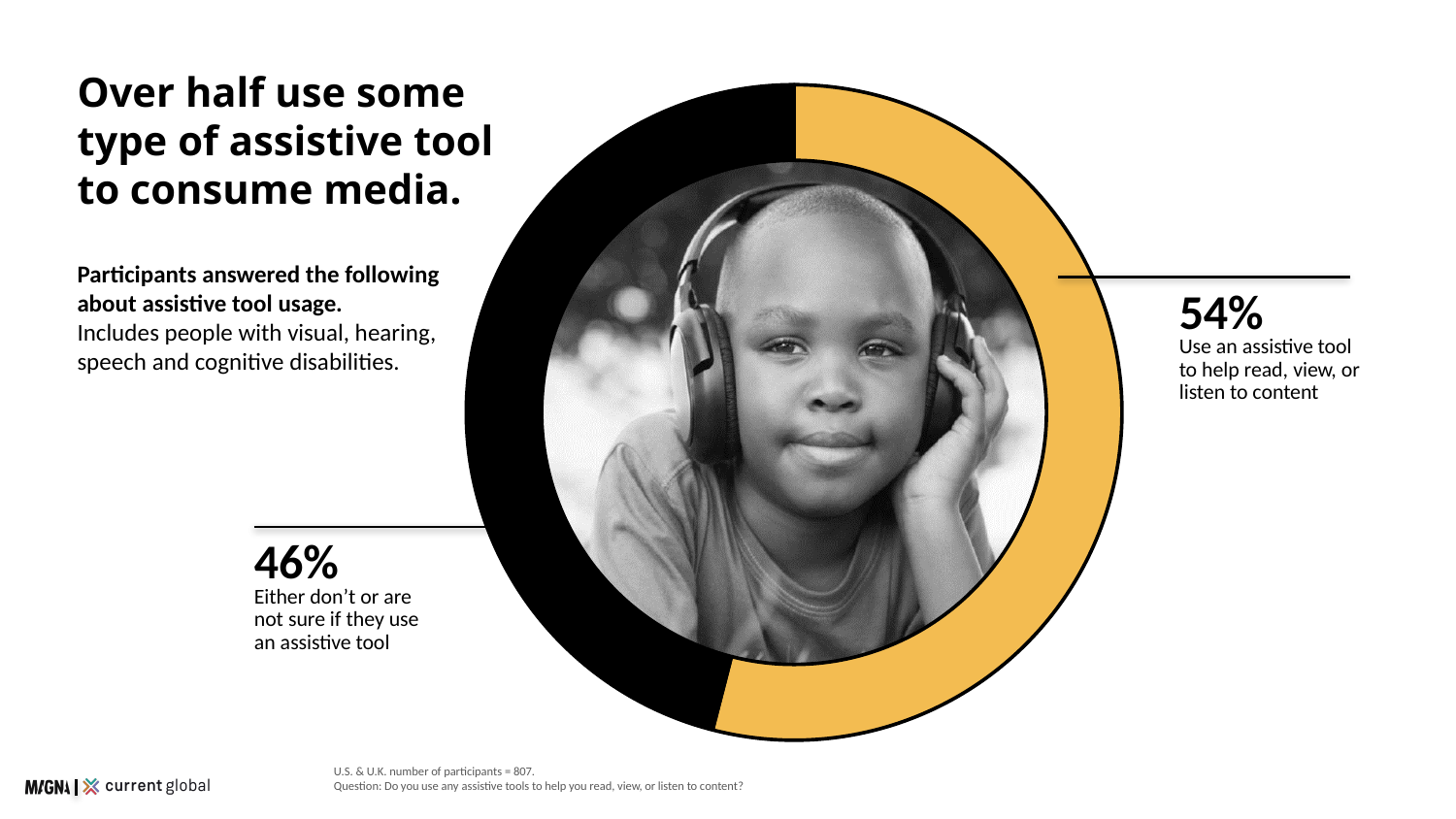
Which segment of the chart is the largest? Use an assistive tool (54%) Which segment is larger: those who use an assistive tool or those who don't or are not sure? Use an assistive tool What kind of chart is shown on the slide? Donut (pie) chart What percentage of participants use an assistive tool to help read, view, or listen to content? 54% How many participants were surveyed according to the footnote? 807 What is the difference in percentage points between those who use an assistive tool and those who don't or are not sure? 8 percentage points Which colour represents the 54% segment that uses an assistive tool? Yellow What percentage of participants either don't or are not sure if they use an assistive tool? 46% Which segment of the chart is the smallest? Either don't or are not sure if they use an assistive tool (46%) How many segments does the chart have? 2 What is the total of the two percentages shown on the chart? 100%